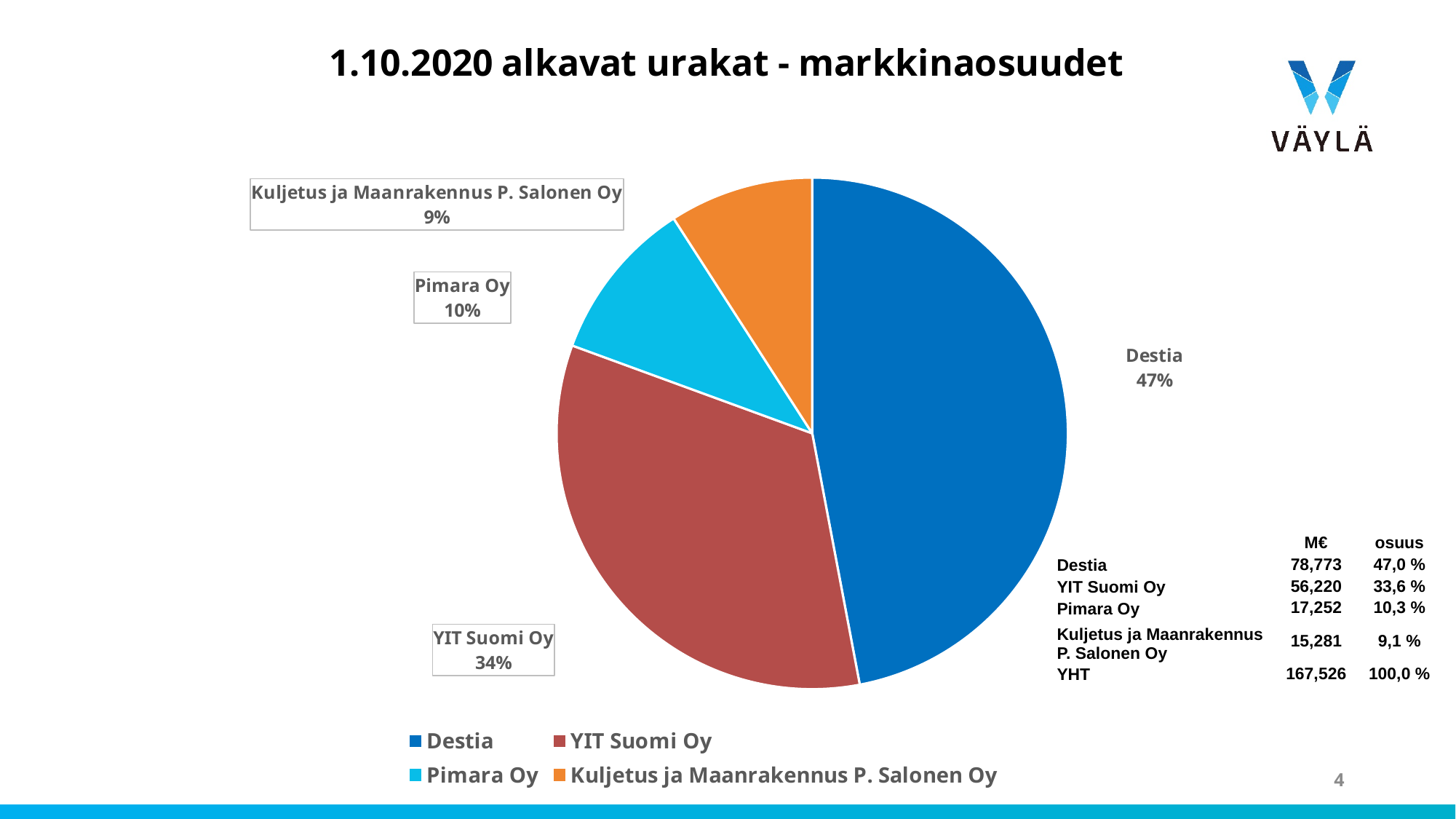
What share of the pie does Pimara Oy hold according to the data label? 10% What share of the pie does Kuljetus ja Maanrakennus P. Salonen Oy hold according to the data label? 9% What share of the pie does Destia hold according to the data label? 47% Which company has the largest slice of the pie? Destia Which company has the smallest slice of the pie? Kuljetus ja Maanrakennus P. Salonen Oy What kind of chart is shown on the slide? pie chart Which slice is larger, Pimara Oy or YIT Suomi Oy? YIT Suomi Oy What is the title of the chart? 1.10.2020 alkavat urakat - markkinaosuudet What is the difference in percentage points between the Destia slice and the YIT Suomi Oy slice, using the chart's data labels? 13% What colour is the Pimara Oy slice in the pie chart? light blue How many slices does the pie chart have? 4